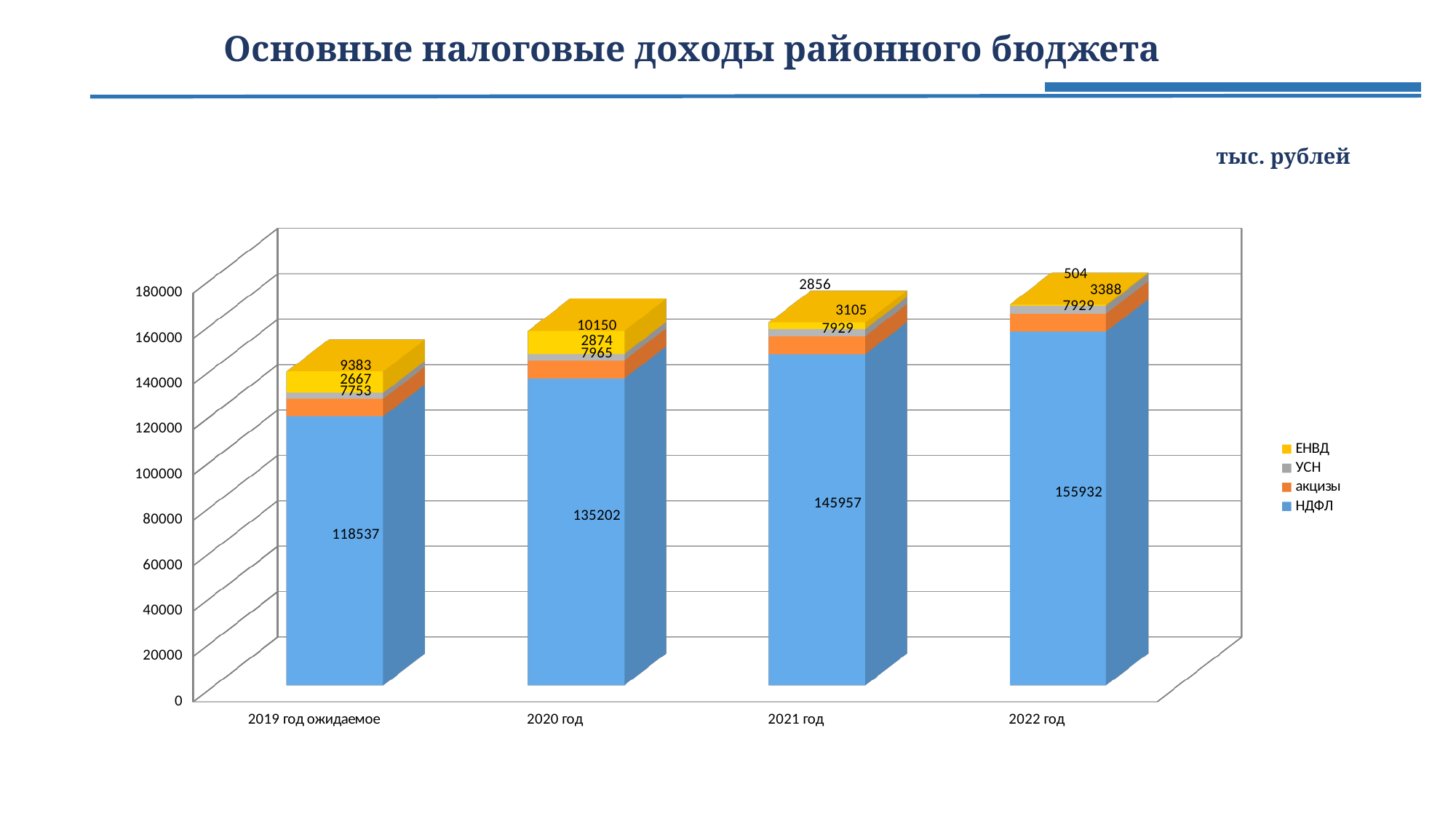
What is the НДФЛ value for 2020 год? 135202 Which is larger, the ЕНВД value for 2020 год or for 2021 год? 2020 год What is the ЕНВД value for 2022 год? 504 Does the НДФЛ value rise or fall from 2019 год ожидаемое to 2022 год? rise How many series does the legend list? 4 Which year has the highest НДФЛ value? 2022 год Which year has the lowest ЕНВД value? 2022 год What is the акцизы value for 2019 год ожидаемое? 7753 What is the difference between the НДФЛ values for 2022 год and 2021 год? 9975 What is the УСН value for 2021 год? 3105 How many categories are shown on the x axis? 4 What is the total of the stacked bar for 2019 год ожидаемое? 138340